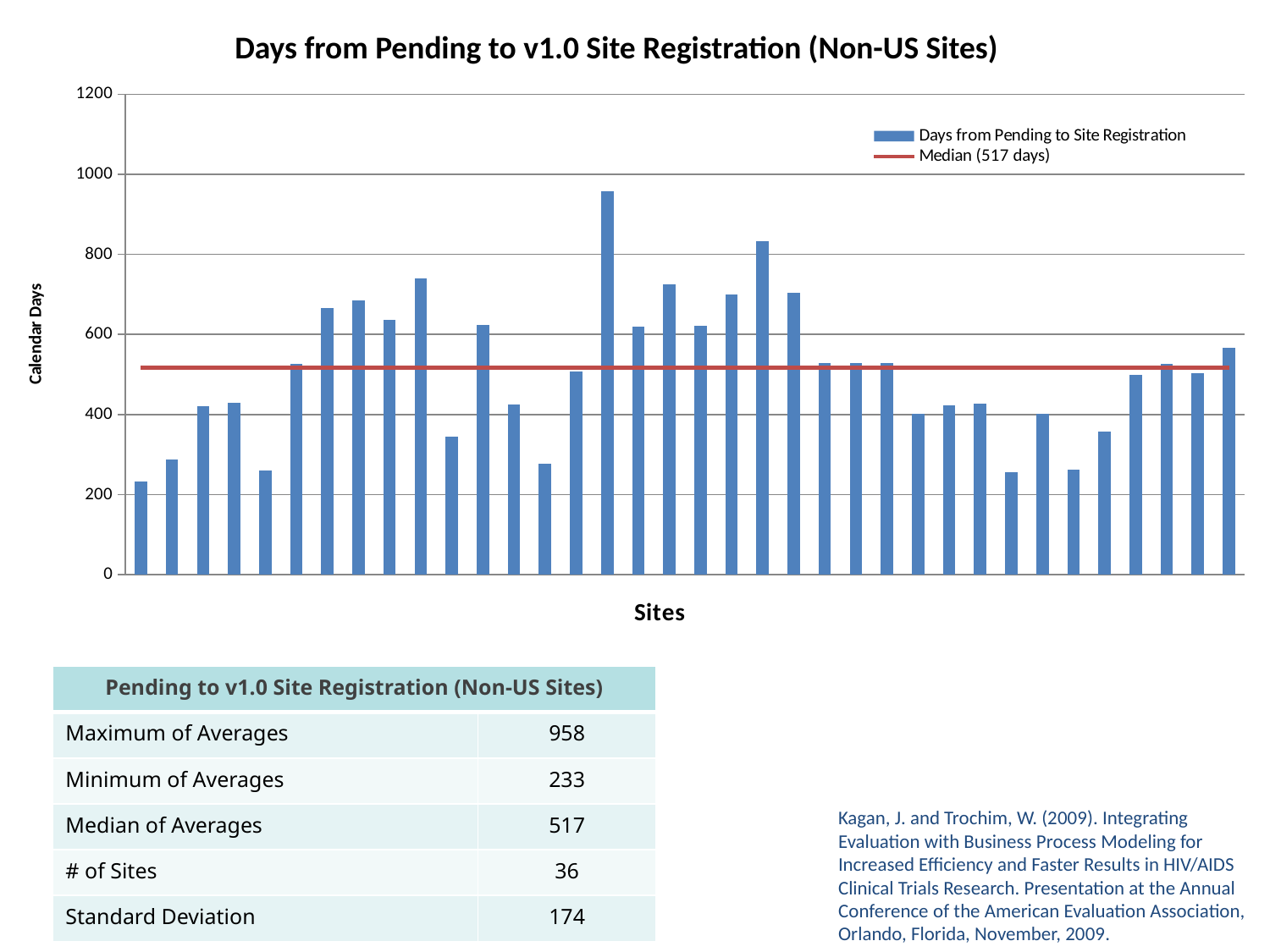
What is the lowest value plotted in the chart (the minimum of averages)? 233 Is the value of the tallest bar in the chart greater or less than 800? greater What is the label on the vertical axis of the chart? Calendar Days How many sites (bars) are plotted in the chart? 36 What is the title of the chart? Days from Pending to v1.0 Site Registration (Non-US Sites) What kind of chart is shown on the slide? Bar chart Is the value of the shortest bar in the chart greater or less than 400? less What is the highest value plotted in the chart (the maximum of averages)? 958 What median value does the red line in the chart represent? 517 days How many entries does the chart legend list? 2 What is the difference between the maximum and minimum of averages shown for the chart? 725 Is the value of the tallest bar in the chart greater or less than 1000? less